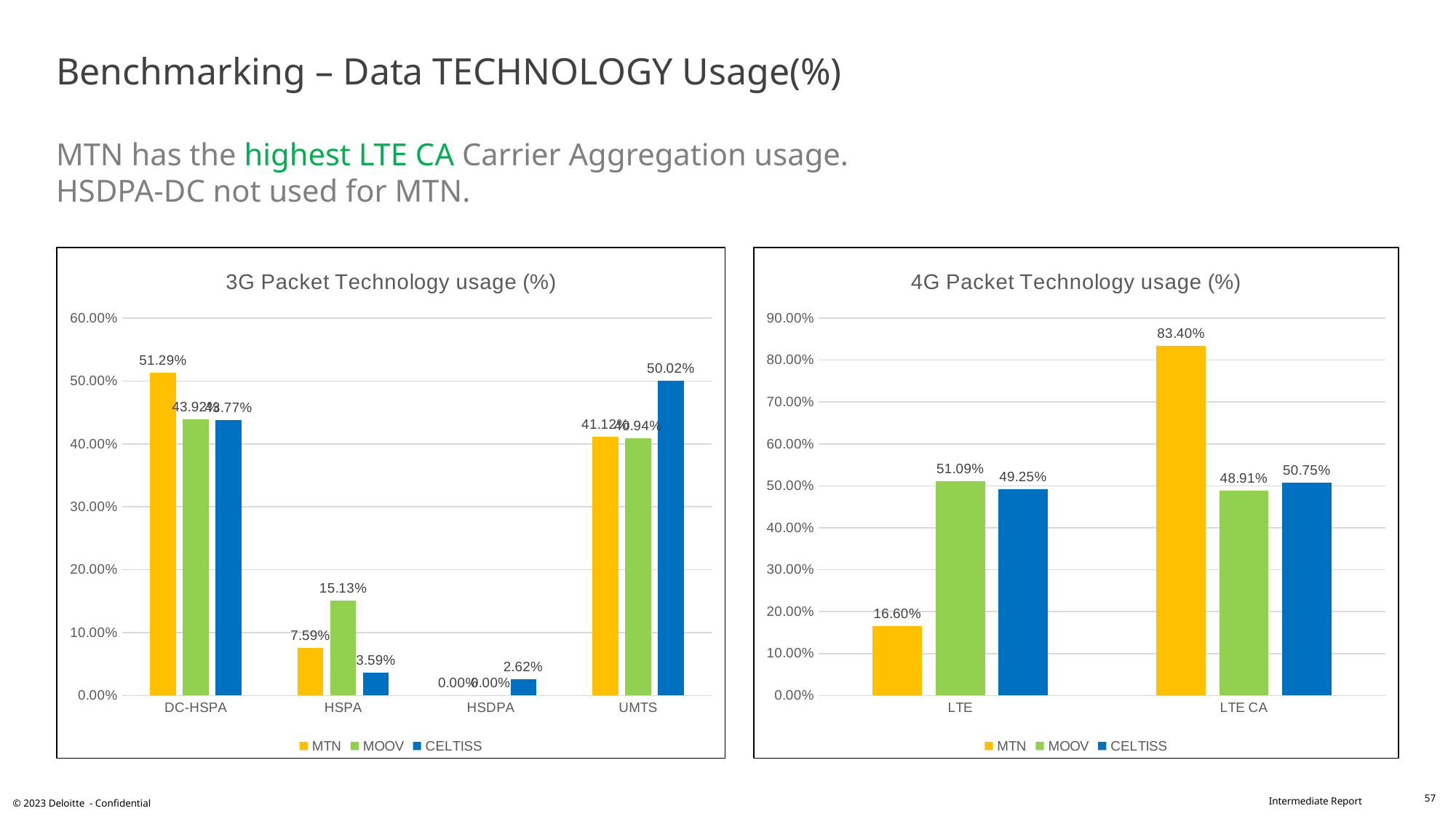
How many categories are shown on the x axis of the 3G Packet Technology usage (%) chart? 4 In the 4G Packet Technology usage (%) chart, what is the value for MOOV in the LTE category? 51.09% In the 3G Packet Technology usage (%) chart, what is the value for CELTISS in the HSDPA category? 2.62% How many series does the legend of the 4G Packet Technology usage (%) chart list? 3 In the 4G Packet Technology usage (%) chart, which operator has the lowest value in the LTE category? MTN In the 3G Packet Technology usage (%) chart, which is larger in the HSPA category: MTN or CELTISS? MTN In the 4G Packet Technology usage (%) chart, what is the value for MTN in the LTE CA category? 83.40% In the 3G Packet Technology usage (%) chart, which operator has the highest value in the UMTS category? CELTISS In the 3G Packet Technology usage (%) chart, what is the value for MOOV in the HSPA category? 15.13% What type of chart is the 4G Packet Technology usage (%) chart? Bar chart In the 4G Packet Technology usage (%) chart, what is the difference between MTN's LTE CA value and MTN's LTE value? 66.80% In the 3G Packet Technology usage (%) chart, is the value for MTN in the DC-HSPA category greater or less than 50.00%? greater